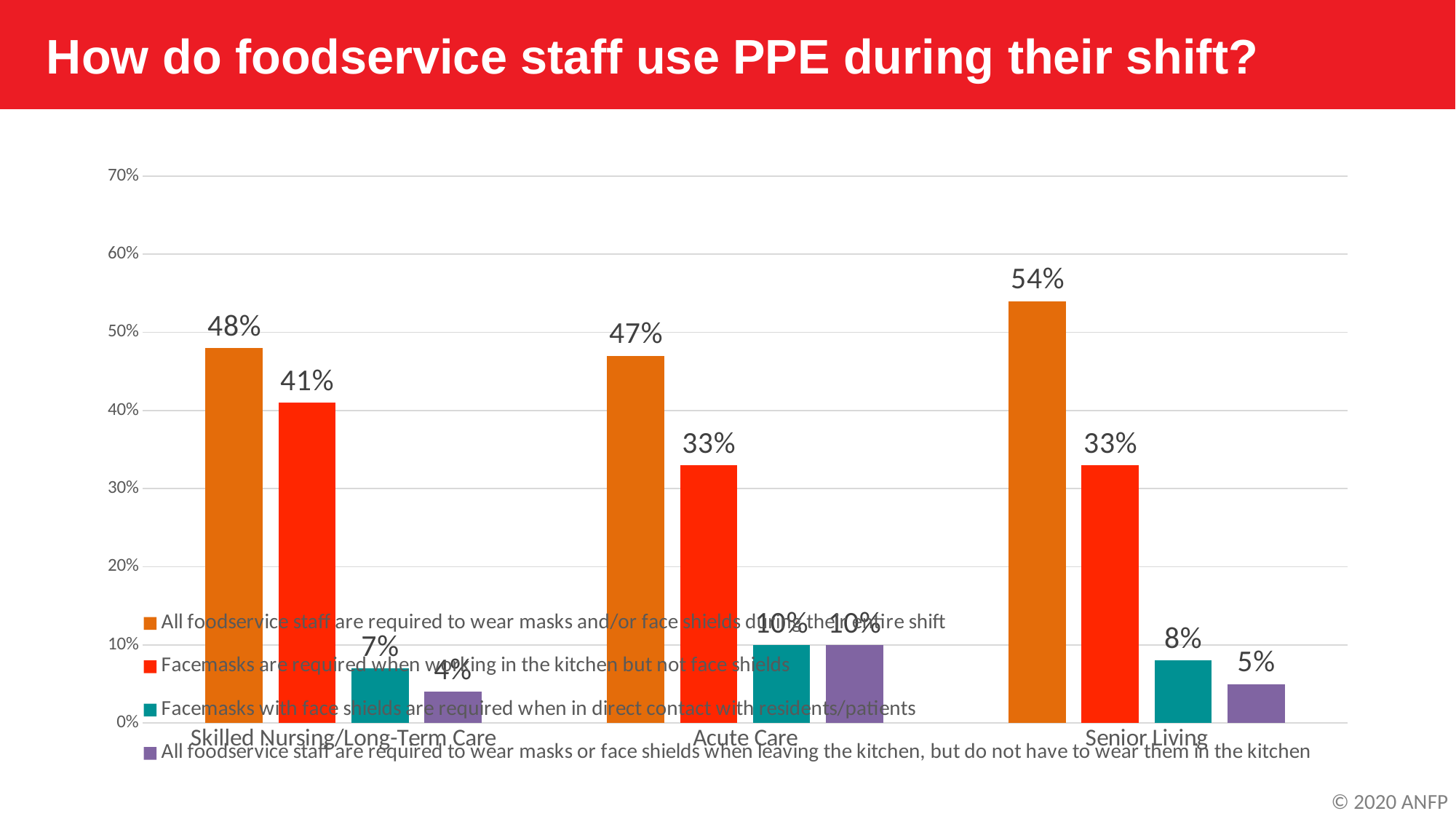
Which category has the highest value for 'All foodservice staff are required to wear masks and/or face shields during their entire shift'? Senior Living How many series does the legend list? 4 What kind of chart is shown on the slide? bar chart Which is larger: the 'Facemasks are required when working in the kitchen but not face shields' value for Skilled Nursing/Long-Term Care or for Senior Living? Skilled Nursing/Long-Term Care What is the value for 'All foodservice staff are required to wear masks and/or face shields during their entire shift' in Senior Living? 54% How many categories are shown on the x axis? 3 Which category has the lowest value for 'Facemasks with face shields are required when in direct contact with residents/patients'? Skilled Nursing/Long-Term Care What is the value for 'All foodservice staff are required to wear masks or face shields when leaving the kitchen, but do not have to wear them in the kitchen' in Skilled Nursing/Long-Term Care? 4% What is the value for 'Facemasks are required when working in the kitchen but not face shields' in Skilled Nursing/Long-Term Care? 41% What colour are the bars for 'Facemasks are required when working in the kitchen but not face shields'? red What is the difference between the 'All foodservice staff are required to wear masks and/or face shields during their entire shift' values for Senior Living and Acute Care? 7% What is the value for 'Facemasks with face shields are required when in direct contact with residents/patients' in Acute Care? 10%